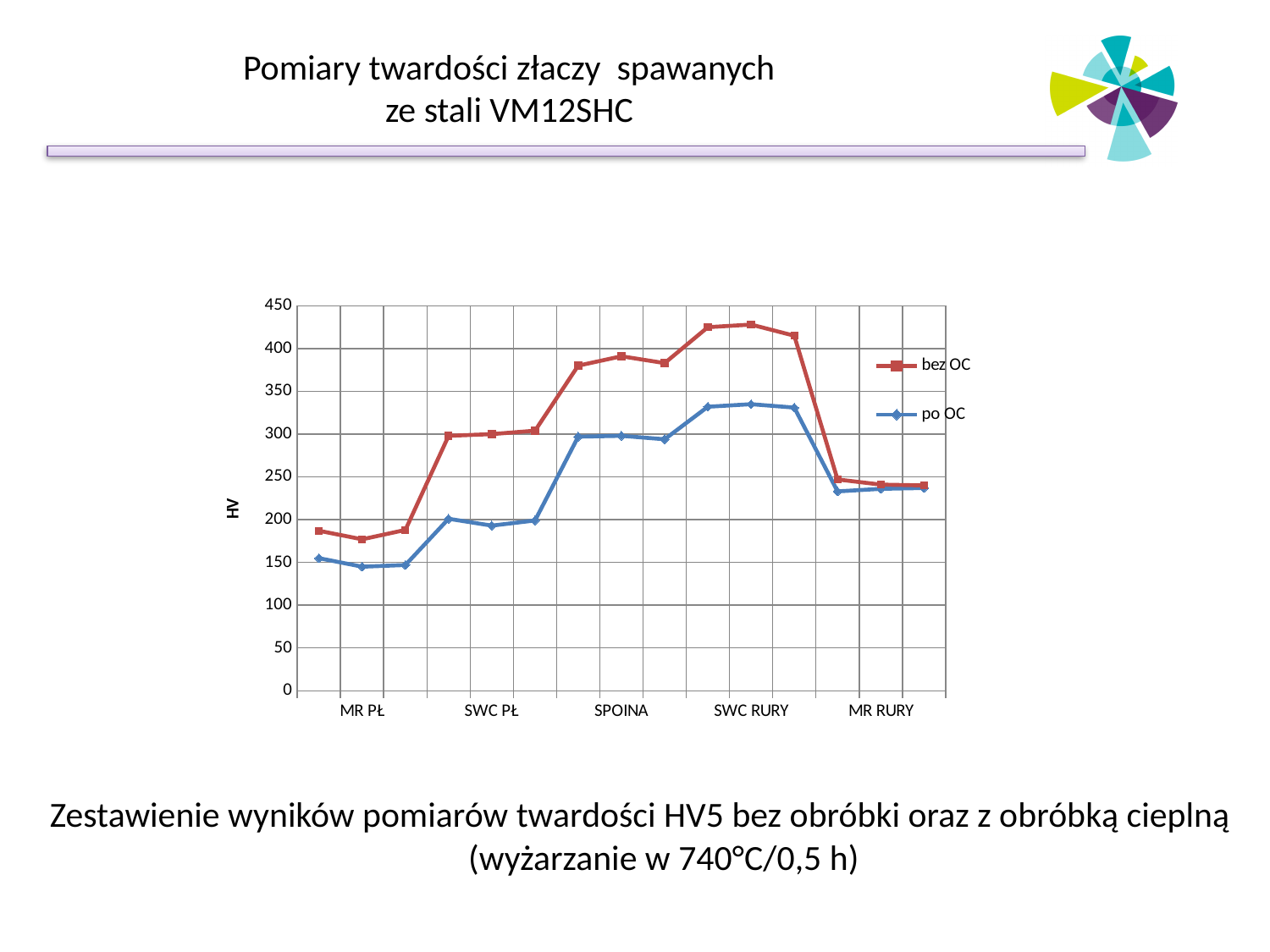
Do the bez OC values rise or fall from MR PŁ to SWC RURY? rise Is the value of po OC at MR PŁ greater or less than 200? less How many categories are labelled on the x axis? 5 At SPOINA, which series has the larger values, bez OC or po OC? bez OC Which series is plotted in red? bez OC In which category does the po OC series have its lowest values? MR PŁ In which category does the bez OC series reach its highest values? SWC RURY Is the value of po OC at SWC RURY greater or less than 300? greater Is the value of bez OC at SWC RURY greater or less than 400? greater How many series does the legend list? 2 What is the label of the vertical axis? HV What kind of chart is shown on the slide? line chart